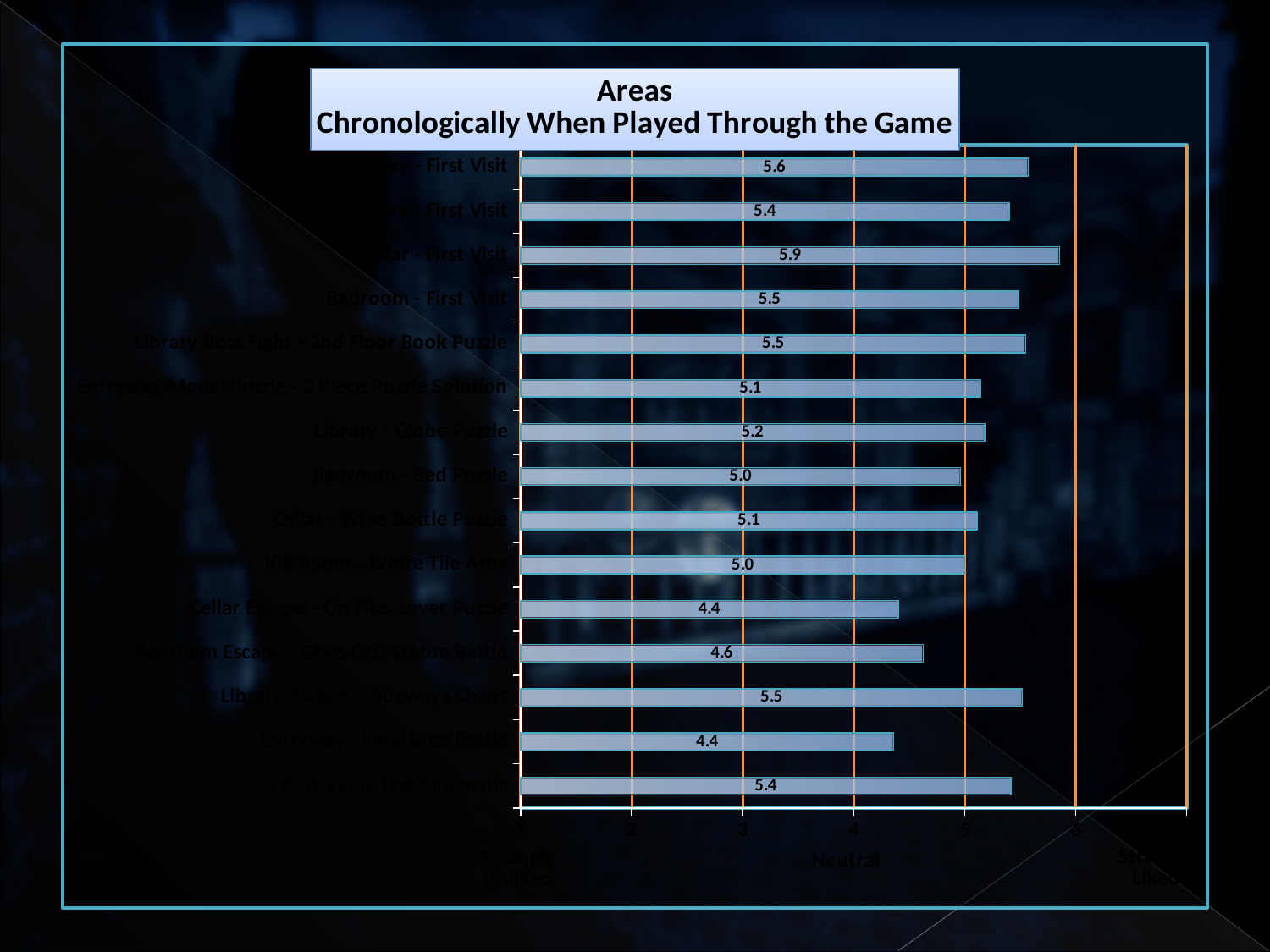
What is the value for Bedroom - First Visit? 5.5 What kind of chart is shown on the slide? bar chart What is the highest value shown on the chart? 5.9 How many categories (bars) are shown on the chart? 15 What is the value for Post-game End Cinematic? 5.4 What is the difference between the values for Library Escape - Sideways Chaos and Bedroom Escape - Glass Orb Statue Battle? 0.9 Which has a larger value, Cellar - Wine Bottle Puzzle or Cellar Escape - On Fire, Lever Puzzle? Cellar - Wine Bottle Puzzle What is the value for Library - Globe Puzzle? 5.2 What is the lowest value shown on the chart? 4.4 What is the title of the chart? Areas Chronologically When Played Through the Game What is the value for Kill Room - White Tile Area? 5.0 What is the value for Entryway - Final Boss Battle? 4.4